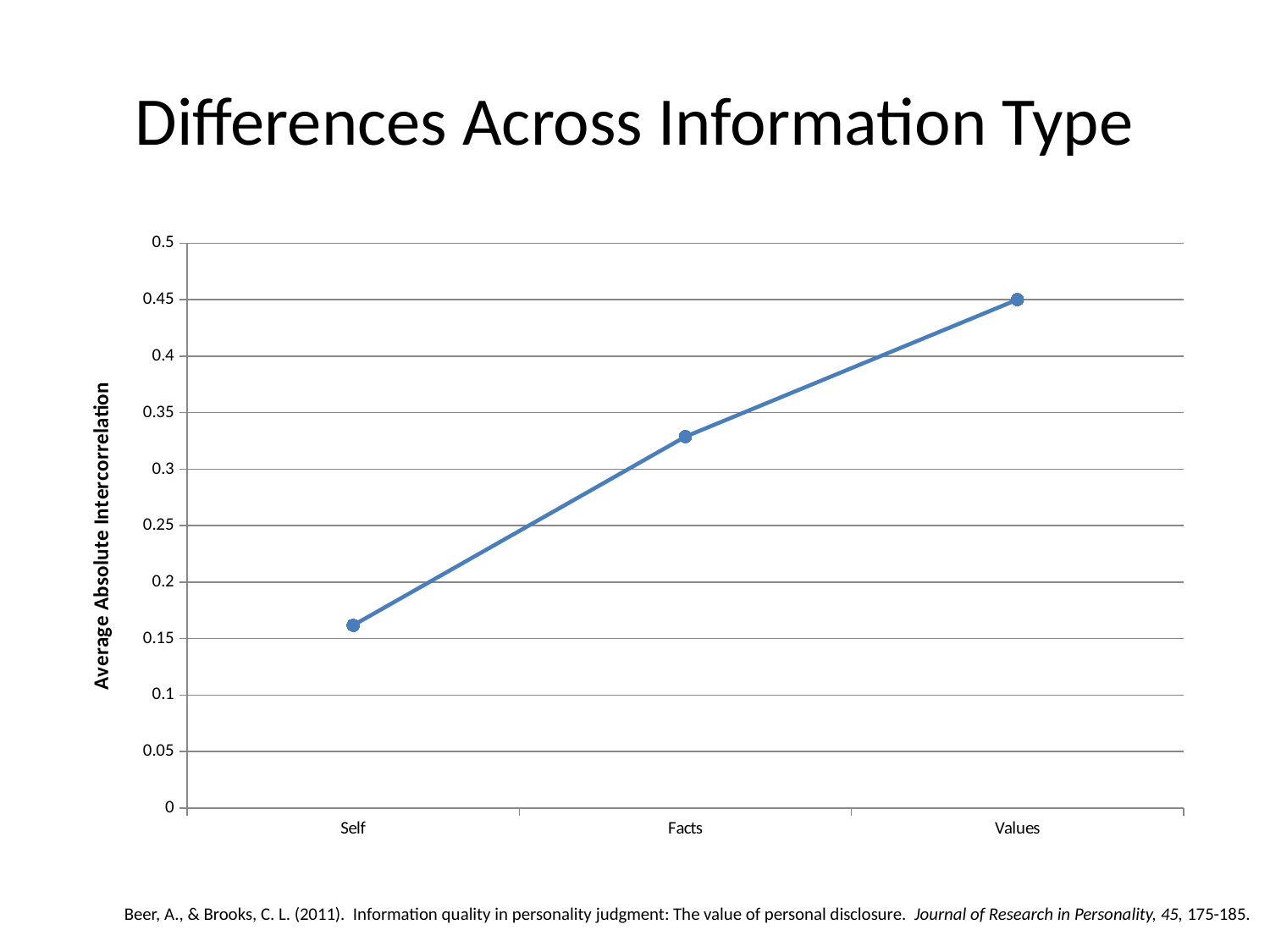
How many information types (categories) are plotted on the x axis? 3 What kind of chart is shown on the slide? line chart Is the value for Values greater or less than 0.4? greater Is the value for Facts greater or less than 0.3? greater What is the title shown above the chart? Differences Across Information Type Is the value for Self greater or less than 0.2? less Which information type has the lowest average absolute intercorrelation? Self Which information type has the highest average absolute intercorrelation? Values What is the label of the y axis? Average Absolute Intercorrelation Which has a larger average absolute intercorrelation, Facts or Self? Facts Do the values rise or fall moving from Self to Values along the x axis? rise